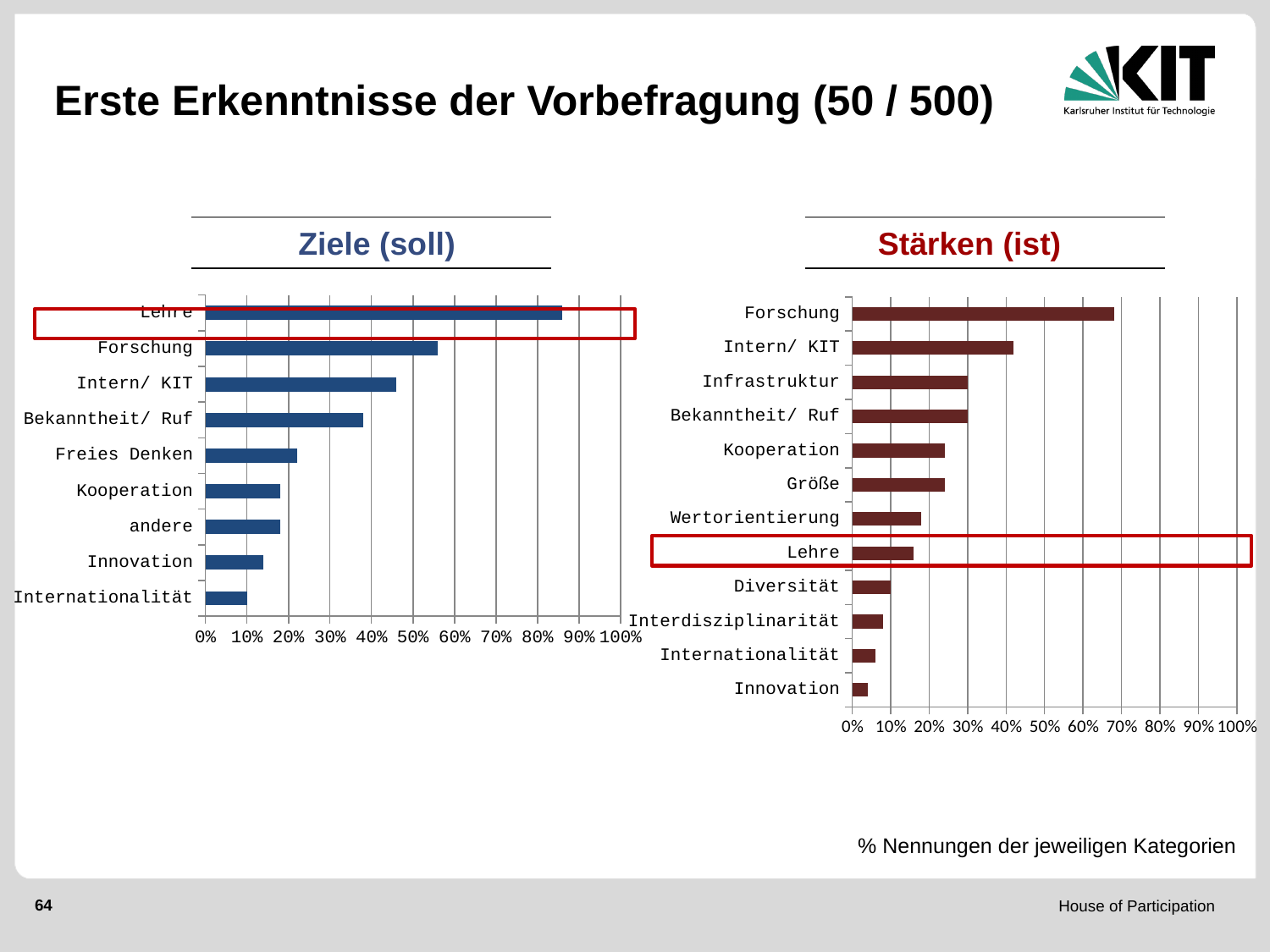
In the 'Ziele (soll)' chart, is the value for Forschung greater or less than 50%? greater In the 'Ziele (soll)' chart, which category has the highest value? Lehre How many categories are shown in the 'Stärken (ist)' chart? 12 In the 'Stärken (ist)' chart, which category has the lowest value? Innovation In the 'Ziele (soll)' chart, is the value for Lehre greater or less than 80%? greater In the 'Stärken (ist)' chart, is the value for Forschung greater or less than 60%? greater What kind of chart is the 'Ziele (soll)' chart? Bar chart In the 'Ziele (soll)' chart, which is larger, the value for Intern/ KIT or the value for Freies Denken? Intern/ KIT In the 'Ziele (soll)' chart, which category has the lowest value? Internationalität In the 'Stärken (ist)' chart, which category has the highest value? Forschung In the 'Stärken (ist)' chart, which is larger, the value for Intern/ KIT or the value for Wertorientierung? Intern/ KIT